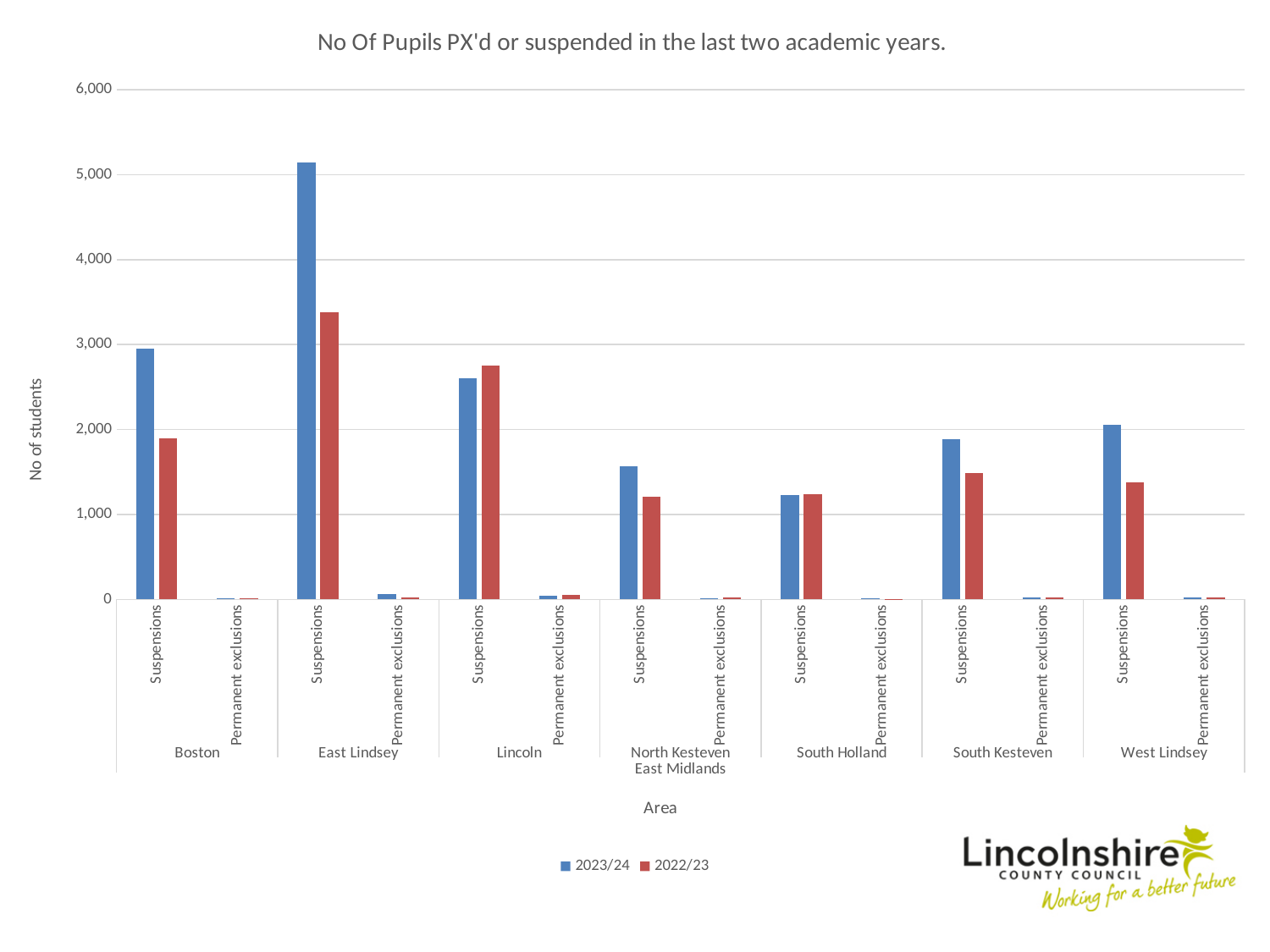
What is the title of the chart? No Of Pupils PX'd or suspended in the last two academic years. For Lincoln suspensions, which series is larger, 2023/24 or 2022/23? 2022/23 How many areas are shown along the x axis? 7 Which area has the lowest number of suspensions for 2023/24? South Holland Which area has the highest number of suspensions for 2023/24? East Lindsey How many series does the legend list? 2 For South Kesteven suspensions, which series is larger, 2023/24 or 2022/23? 2023/24 Is the value for East Lindsey suspensions in 2023/24 greater or less than 5,000? greater Is the value for Lincoln suspensions in 2023/24 greater or less than 3,000? less What kind of chart is shown on the slide? bar chart Is the value for Boston suspensions in 2022/23 greater or less than 2,000? less